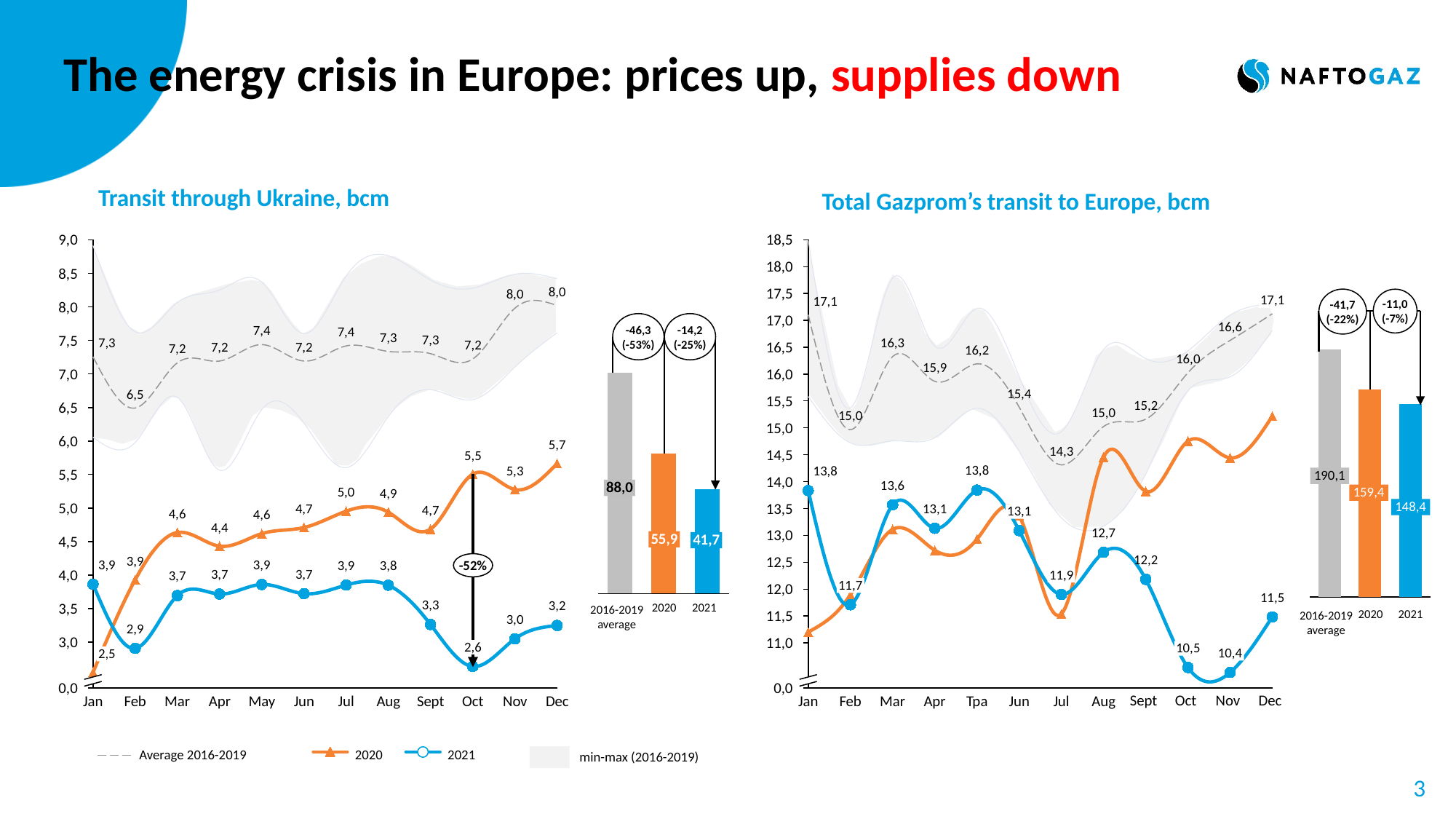
On the small bar chart next to the 'Total Gazprom's transit to Europe' chart, what is the value for 2021? 148,4 On the 'Transit through Ukraine, bcm' chart, what is the Average 2016-2019 value for Feb? 6,5 On the 'Total Gazprom's transit to Europe, bcm' chart, what is the 2021 value for Nov? 10,4 On the small bar chart next to the 'Transit through Ukraine' chart, what is the value for the 2016-2019 average? 88,0 On the 'Transit through Ukraine, bcm' chart, in which month is the 2021 series lowest? Oct How many series does the legend at the bottom of the slide list? 4 On the 'Transit through Ukraine, bcm' chart, what is the 2020 value for Dec? 5,7 On the 'Transit through Ukraine, bcm' chart, what is the 2021 value for Oct? 2,6 On the 'Total Gazprom's transit to Europe, bcm' chart, which is larger for Dec: the Average 2016-2019 value or the 2021 value? Average 2016-2019 On the 'Transit through Ukraine, bcm' chart, what is the difference between the 2020 and 2021 values for Oct? 2,9 On the 'Transit through Ukraine, bcm' chart, in which month is the 2020 series highest? Dec On the 'Total Gazprom's transit to Europe, bcm' chart, what is the Average 2016-2019 value for Jul? 14,3